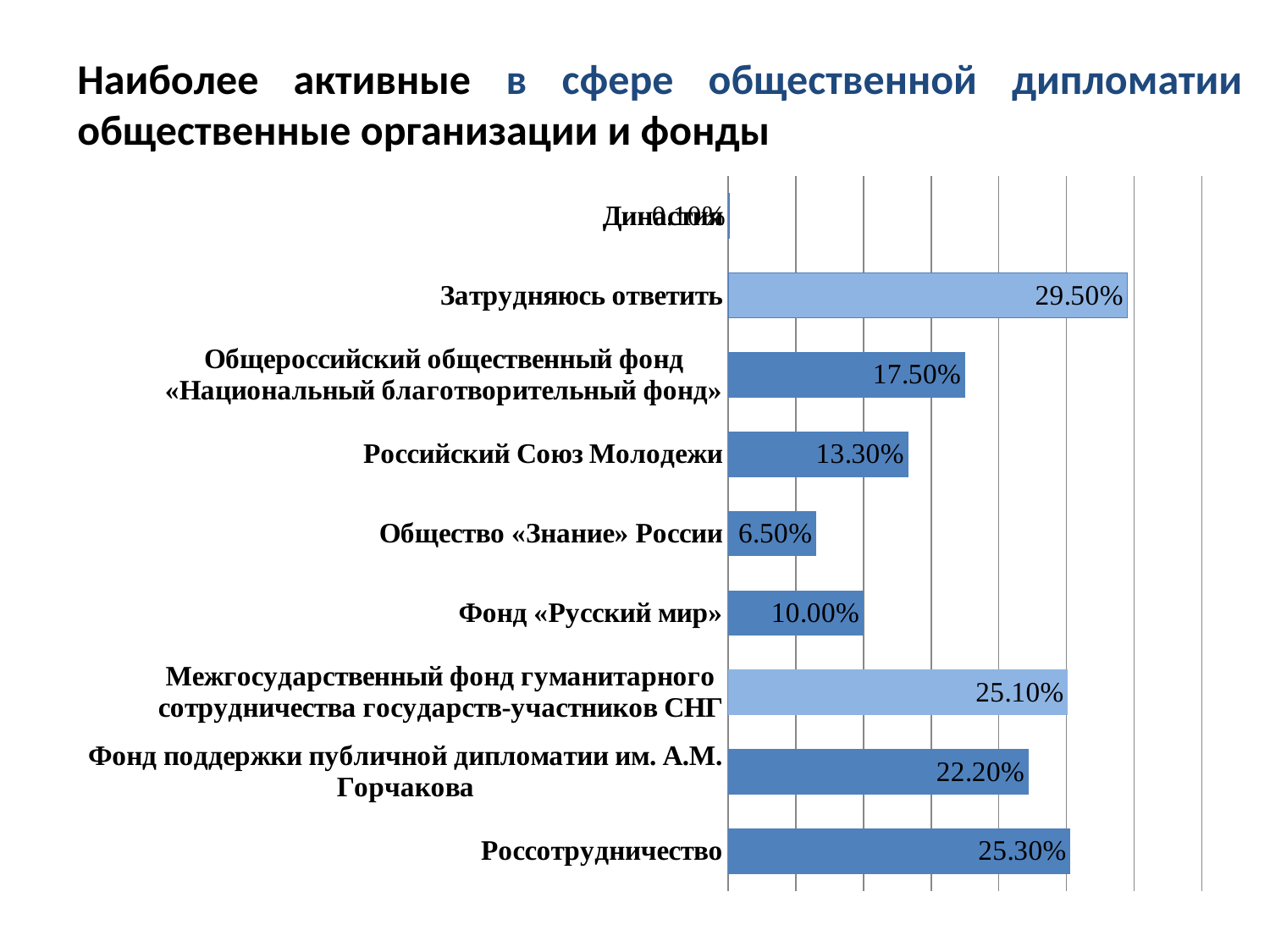
What is the value for Фонд поддержки публичной дипломатии им. А.М. Горчакова? 22.20% What is the value for Россотрудничество? 25.30% What is the difference between Затрудняюсь ответить and Общероссийский общественный фонд «Национальный благотворительный фонд»? 12.00% What is the difference between Российский Союз Молодежи and Общество «Знание» России? 6.80% Which category has the lowest value? Династия What is the value for Фонд «Русский мир»? 10.00% How many categories are shown in the chart? 9 What is the value for Затрудняюсь ответить? 29.50% What kind of chart is shown on the slide? Bar chart Which category has the highest value? Затрудняюсь ответить Which is larger: Российский Союз Молодежи or Фонд «Русский мир»? Российский Союз Молодежи What is the value for Общество «Знание» России? 6.50%